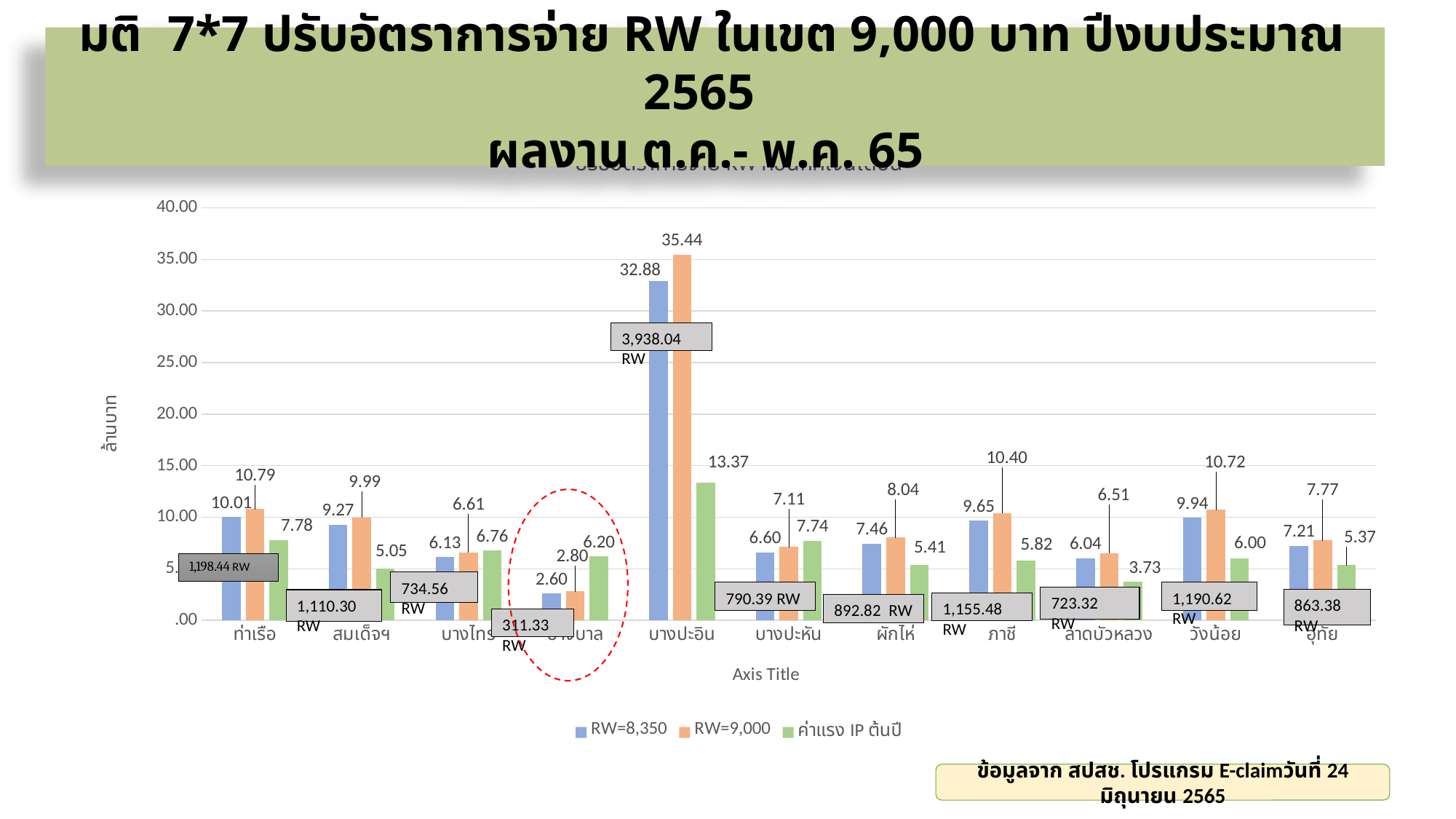
What is the value of the RW=8,350 series for ท่าเรือ? 10.01 Which category has the lowest value in the ค่าแรง IP ต้นปี series? ลาดบัวหลวง Is the RW=9,000 value for ภาชี greater or less than 10.00? greater How many categories are shown on the x axis? 11 For บางปะหัน, which is larger: the RW=9,000 value or the ค่าแรง IP ต้นปี value? ค่าแรง IP ต้นปี Which category has the highest value in the RW=8,350 series? บางปะอิน What is the value of the RW=9,000 series for บางปะอิน? 35.44 What is the label on the vertical axis of the chart? ล้านบาท What is the difference between the RW=9,000 and RW=8,350 values for บางปะอิน? 2.56 How many series does the legend list? 3 What kind of chart is shown on the slide? bar chart What is the value of the ค่าแรง IP ต้นปี series for วังน้อย? 6.00